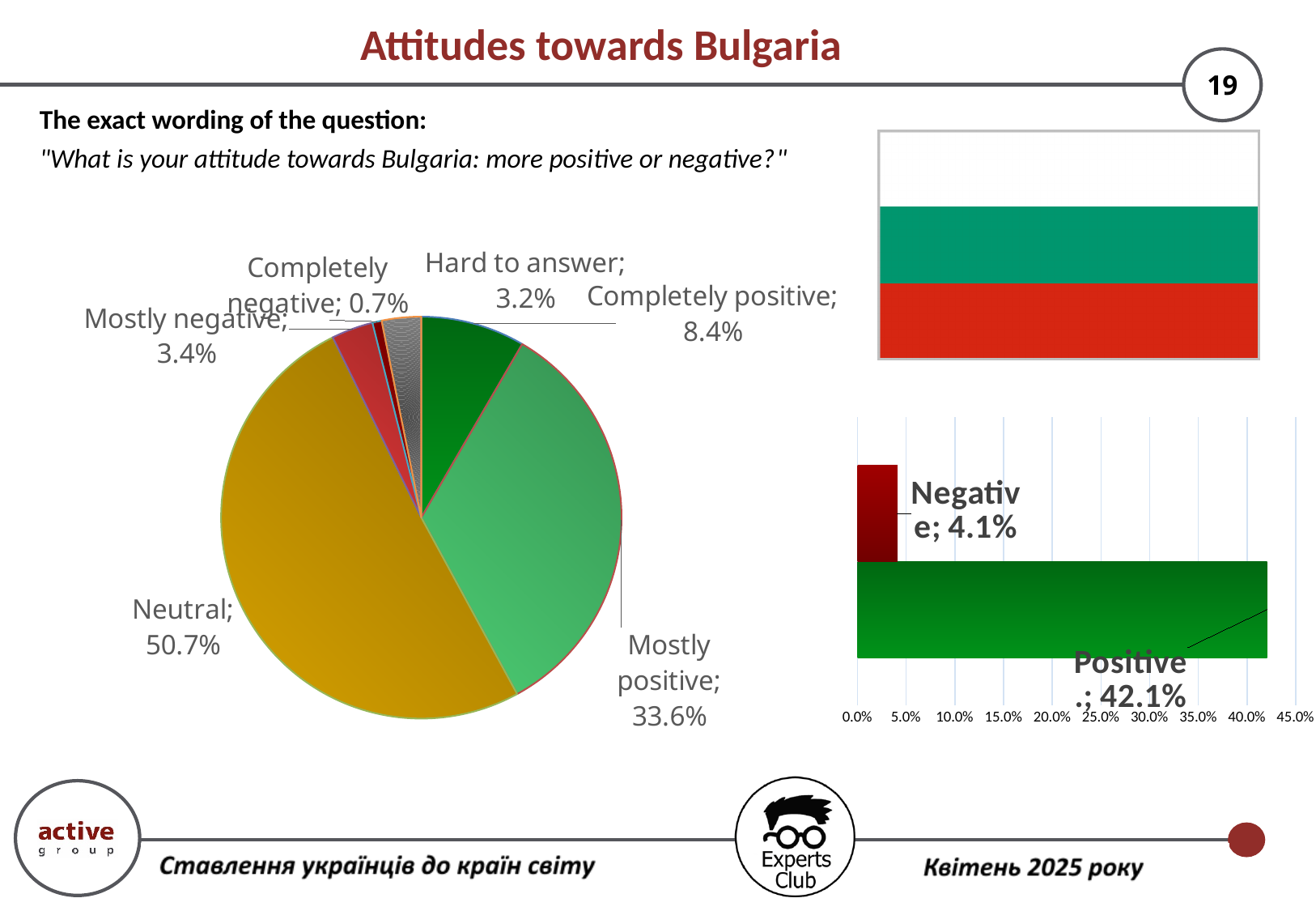
In the pie chart on the left, what is the difference between the "Mostly positive" and "Completely positive" shares? 25.2% In the pie chart on the left, which category has the largest share? Neutral What type of chart is shown on the right side of the slide? Bar chart In the pie chart on the left, how many categories are shown? 6 In the pie chart on the left, what share of respondents answered "Mostly positive"? 33.6% In the bar chart on the right, what is the value for "Negative"? 4.1% In the bar chart on the right, what is the difference between the "Positive" and "Negative" values? 38.0% In the pie chart on the left, which is larger: "Mostly negative" or "Hard to answer"? Mostly negative In the pie chart on the left, which category has the smallest share? Completely negative In the bar chart on the right, what is the value for "Positive"? 42.1% In the pie chart on the left, what share of respondents answered "Completely negative"? 0.7% In the pie chart on the left, what share of respondents answered "Neutral"? 50.7%